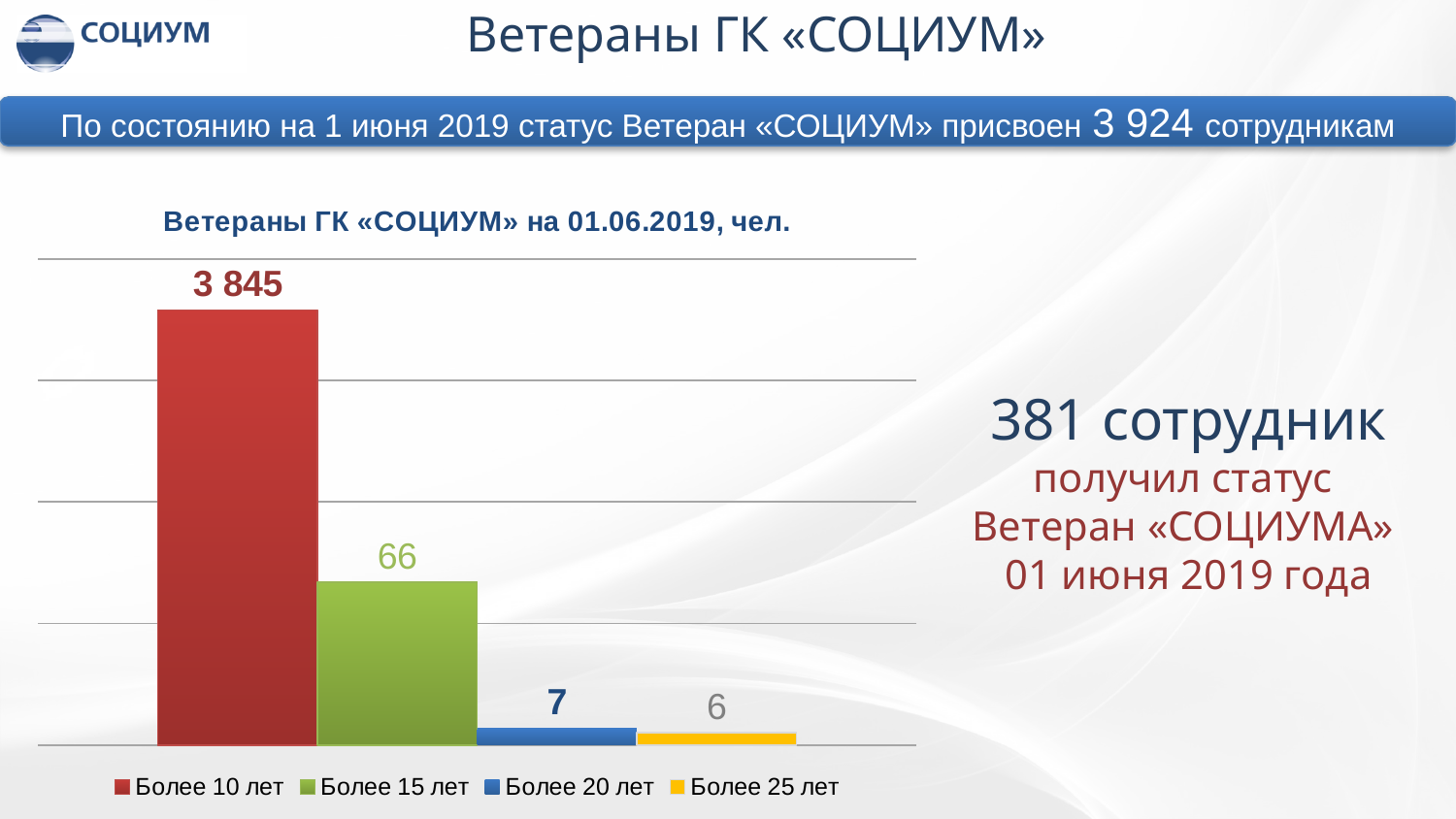
How many series does the legend list? 4 Which category has the lowest value? Более 25 лет What is the difference between the values for «Более 15 лет» and «Более 20 лет»? 59 What is the value for «Более 10 лет»? 3 845 Which category has the highest value? Более 10 лет What kind of chart is shown on the slide? Bar chart What is the value for «Более 20 лет»? 7 Which is larger, the value for «Более 20 лет» or «Более 25 лет»? Более 20 лет What is the value for «Более 15 лет»? 66 What is the total of all four bars in the chart? 3 924 What is the value for «Более 25 лет»? 6 What is the title of the chart? Ветераны ГК «СОЦИУМ» на 01.06.2019, чел.